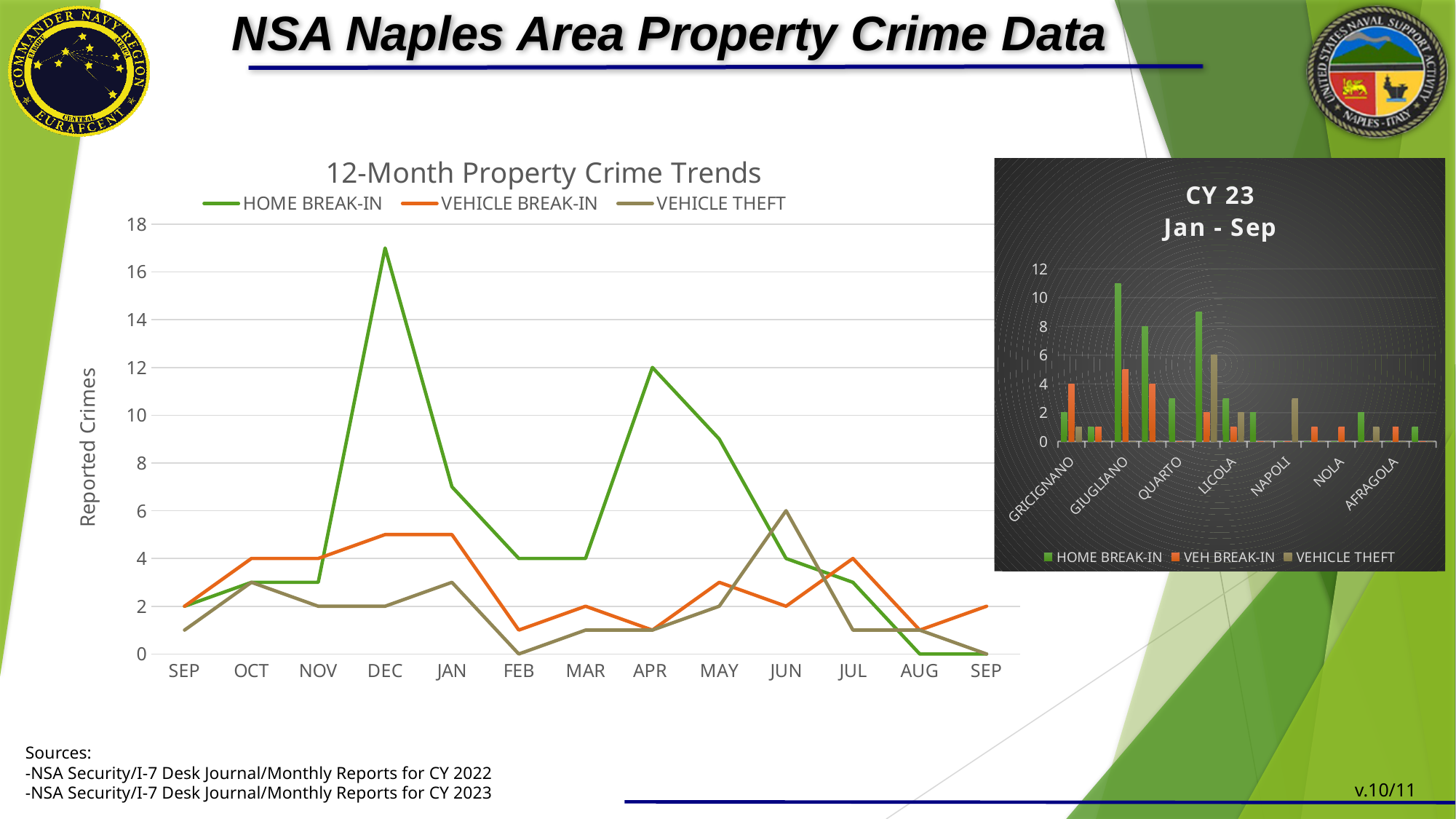
In the "CY 23 Jan - Sep" chart, is the HOME BREAK-IN value for GIUGLIANO greater or less than 10? greater In the "12-Month Property Crime Trends" chart, what is the VEHICLE THEFT value for JUN? 6 In the "12-Month Property Crime Trends" chart, in which month does HOME BREAK-IN reach its highest value? DEC What kind of chart is the "12-Month Property Crime Trends" chart? line chart In the "CY 23 Jan - Sep" chart, which location has the highest HOME BREAK-IN bar? GIUGLIANO What kind of chart is the "CY 23 Jan - Sep" chart? bar chart How many months are shown on the x axis of the "12-Month Property Crime Trends" chart? 13 How many series does the legend of the "12-Month Property Crime Trends" chart list? 3 In the "12-Month Property Crime Trends" chart, is the HOME BREAK-IN value for DEC greater or less than 16? greater In the "12-Month Property Crime Trends" chart, what is the HOME BREAK-IN value for APR? 12 In the "12-Month Property Crime Trends" chart, what is the VEHICLE BREAK-IN value for JUL? 4